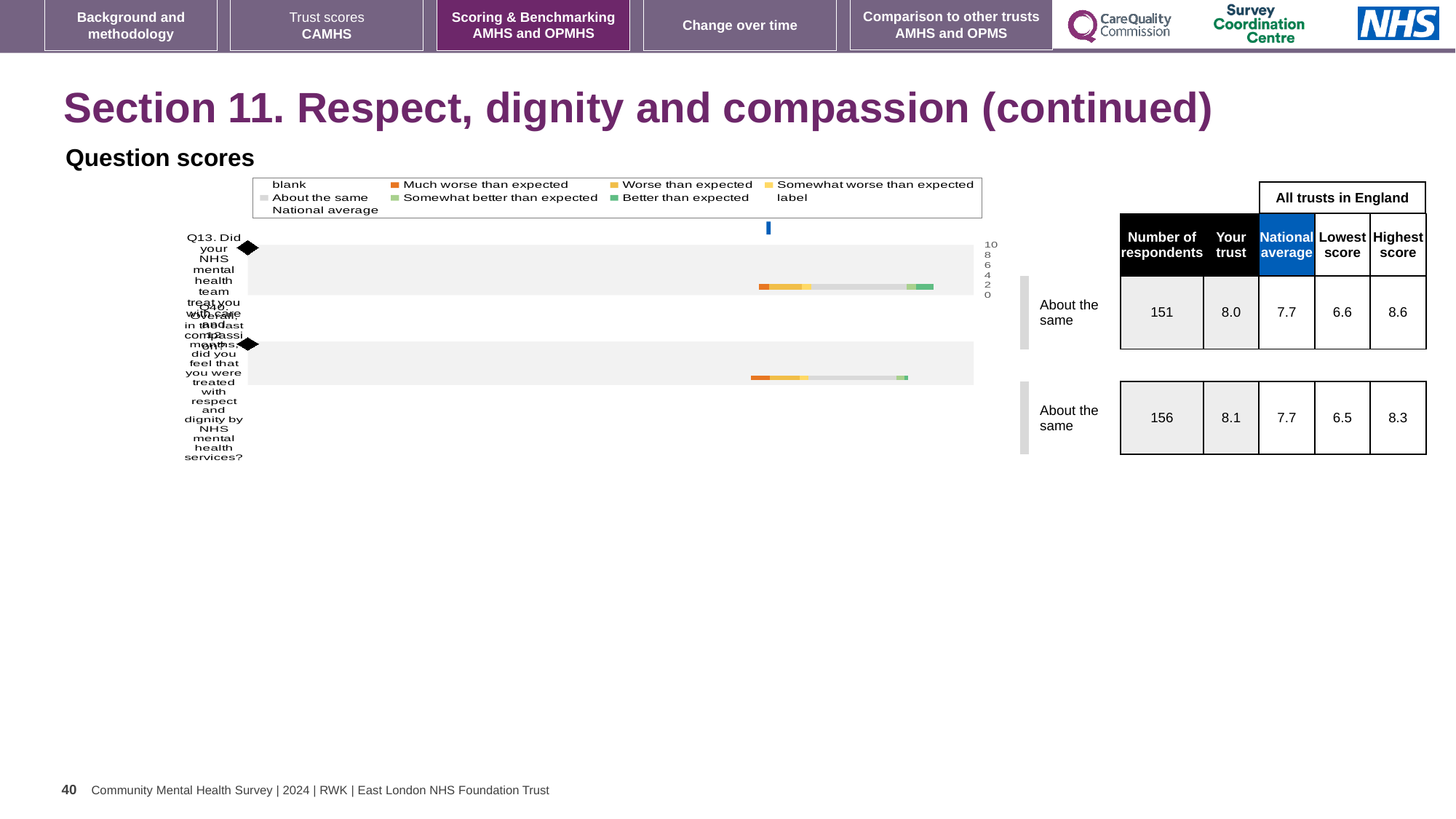
How many respondents are listed for the top row (Q13) in the table beside the chart? 151 How many respondents are listed for the bottom row (Q10) in the table beside the chart? 156 What is the national average score shown for the top row (Q13)? 7.7 In the table next to the chart, what is the 'Your trust' score for the top row (Q13, care and compassion)? 8.0 In the table next to the chart, what is the 'Your trust' score for the bottom row (Q10, respect and dignity)? 8.1 How many survey questions are plotted in the 'Question scores' chart? 2 For the top row (Q13), which is larger: the 'Your trust' score or the national average? Your trust What kind of chart is shown under 'Question scores'? bar chart For the bottom row (Q10), what is the difference between the highest score (8.3) and the lowest score (6.5)? 1.8 What is the highest score across all trusts in England for the top row (Q13)? 8.6 What is the lowest score across all trusts in England for the bottom row (Q10)? 6.5 What benchmark category label is shown beside both rows of the chart? About the same